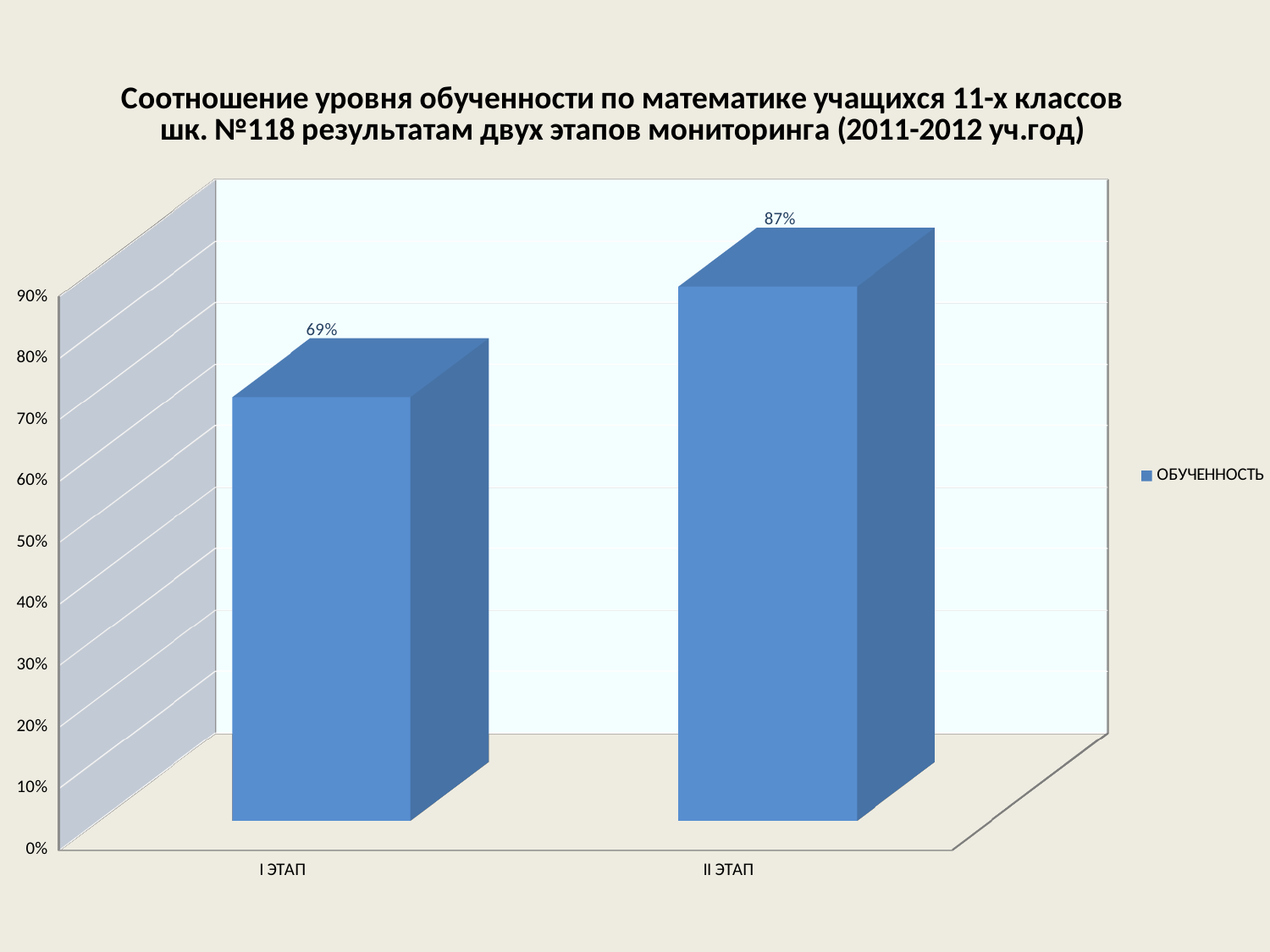
Which stage has the highest value? II ЭТАП What is the value for I ЭТАП? 69% What is the value for II ЭТАП? 87% Is the value for I ЭТАП greater or less than 60%? greater Is the value for II ЭТАП greater or less than 90%? less What is the difference between the values for II ЭТАП and I ЭТАП? 18% Which stage has the lowest value? I ЭТАП How many categories are shown on the x axis? 2 How many series does the legend list? 1 Which is larger, the value for I ЭТАП or the value for II ЭТАП? II ЭТАП What is the name of the series shown in the legend? ОБУЧЕННОСТЬ What kind of chart is shown on the slide? bar chart